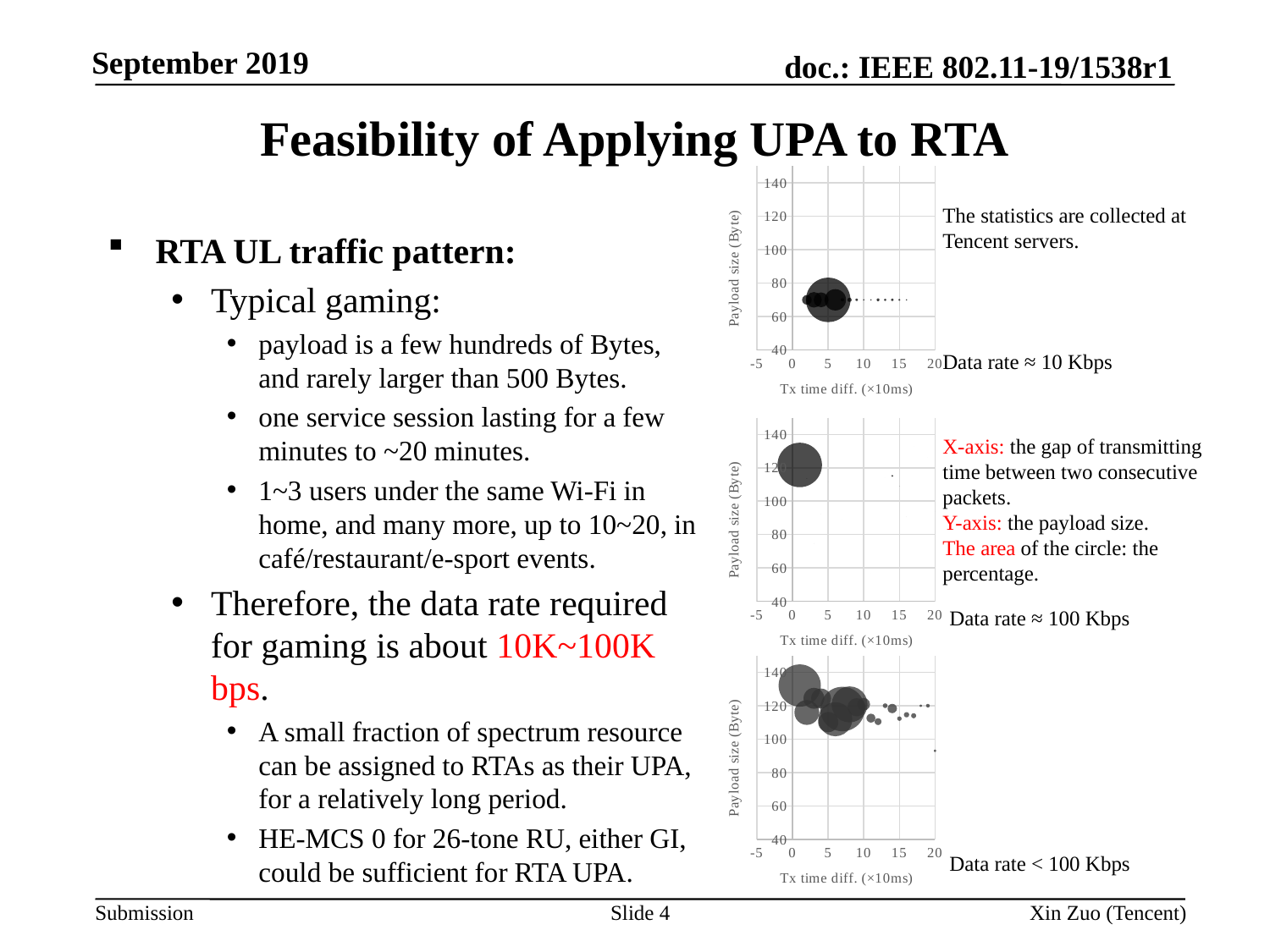
What kind of chart is the top chart on the right side of the slide? bubble chart What is the x-axis label of the bottom chart? Tx time diff. (×10ms) Which chart has its largest bubble at a higher payload size, the top chart or the middle chart? the middle chart In the top chart, is the payload size of the largest bubble greater or less than 100 Bytes? less What is the y-axis label of the top chart? Payload size (Byte) What is the maximum value shown on the y-axis of the bottom chart? 140 In the middle chart, is the Tx time diff. of the largest bubble greater or less than 5 (×10ms)? less How many charts are shown on the slide? 3 In the top chart, is the payload size of the largest bubble greater or less than 60 Bytes? greater